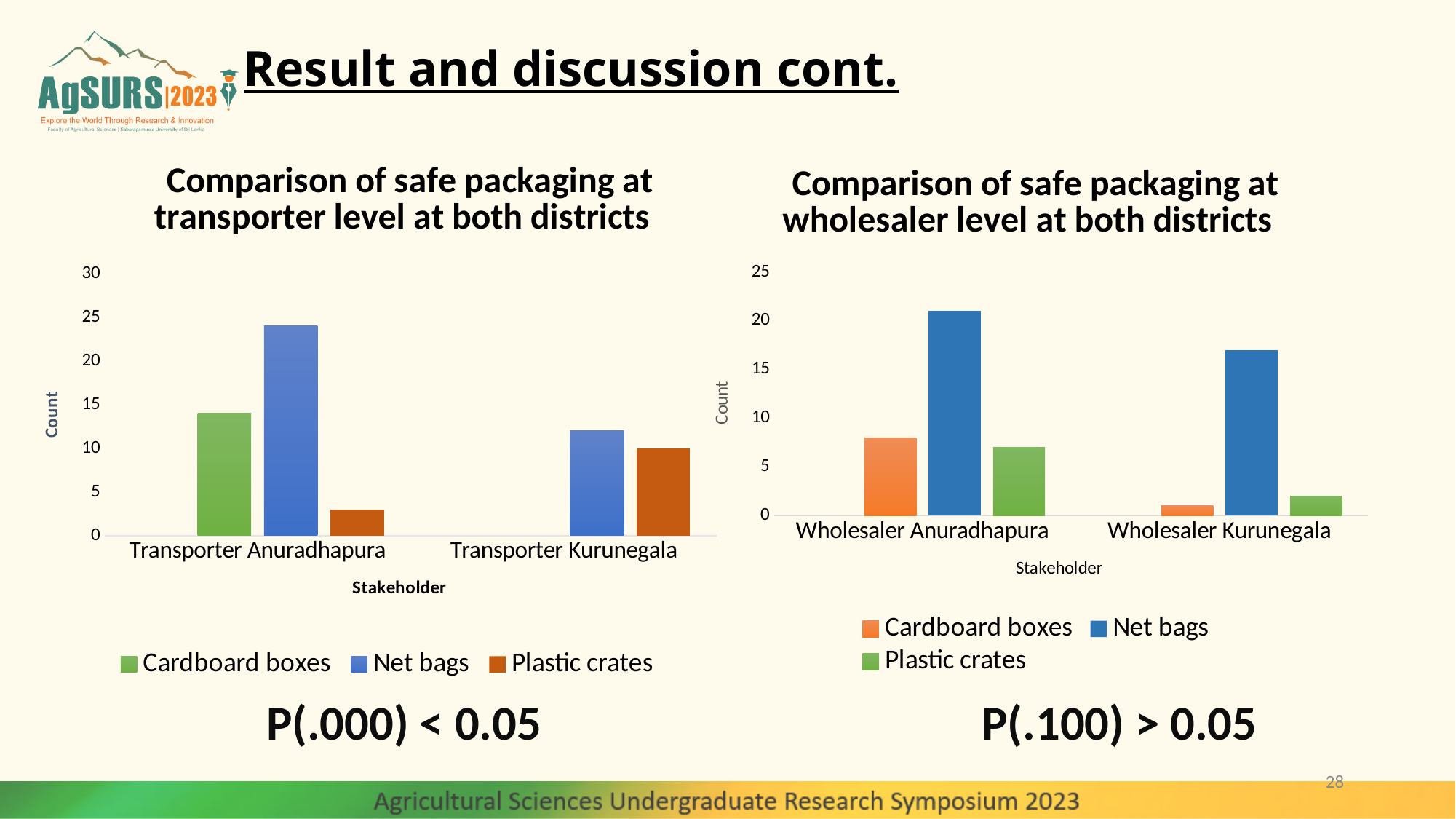
In the chart titled 'Comparison of safe packaging at transporter level at both districts', is the Net bags value for Transporter Anuradhapura greater or less than 20? greater In the chart titled 'Comparison of safe packaging at transporter level at both districts', which packaging type has the highest count for Transporter Anuradhapura? Net bags In the chart titled 'Comparison of safe packaging at transporter level at both districts', is the Plastic crates value for Transporter Anuradhapura greater or less than 5? less In the chart titled 'Comparison of safe packaging at transporter level at both districts', what kind of chart is shown? bar chart In the chart titled 'Comparison of safe packaging at transporter level at both districts', how many stakeholder categories are shown on the x axis? 2 In the chart titled 'Comparison of safe packaging at transporter level at both districts', how many series does the legend list? 3 In the chart titled 'Comparison of safe packaging at transporter level at both districts', which is larger for Transporter Kurunegala: Net bags or Plastic crates? Net bags In the chart titled 'Comparison of safe packaging at wholesaler level at both districts', what is the label of the y axis? Count In the chart titled 'Comparison of safe packaging at wholesaler level at both districts', which packaging type has the lowest count for Wholesaler Kurunegala? Cardboard boxes In the chart titled 'Comparison of safe packaging at wholesaler level at both districts', which packaging type has the highest count for Wholesaler Kurunegala? Net bags In the chart titled 'Comparison of safe packaging at wholesaler level at both districts', is the Net bags value for Wholesaler Kurunegala greater or less than 15? greater